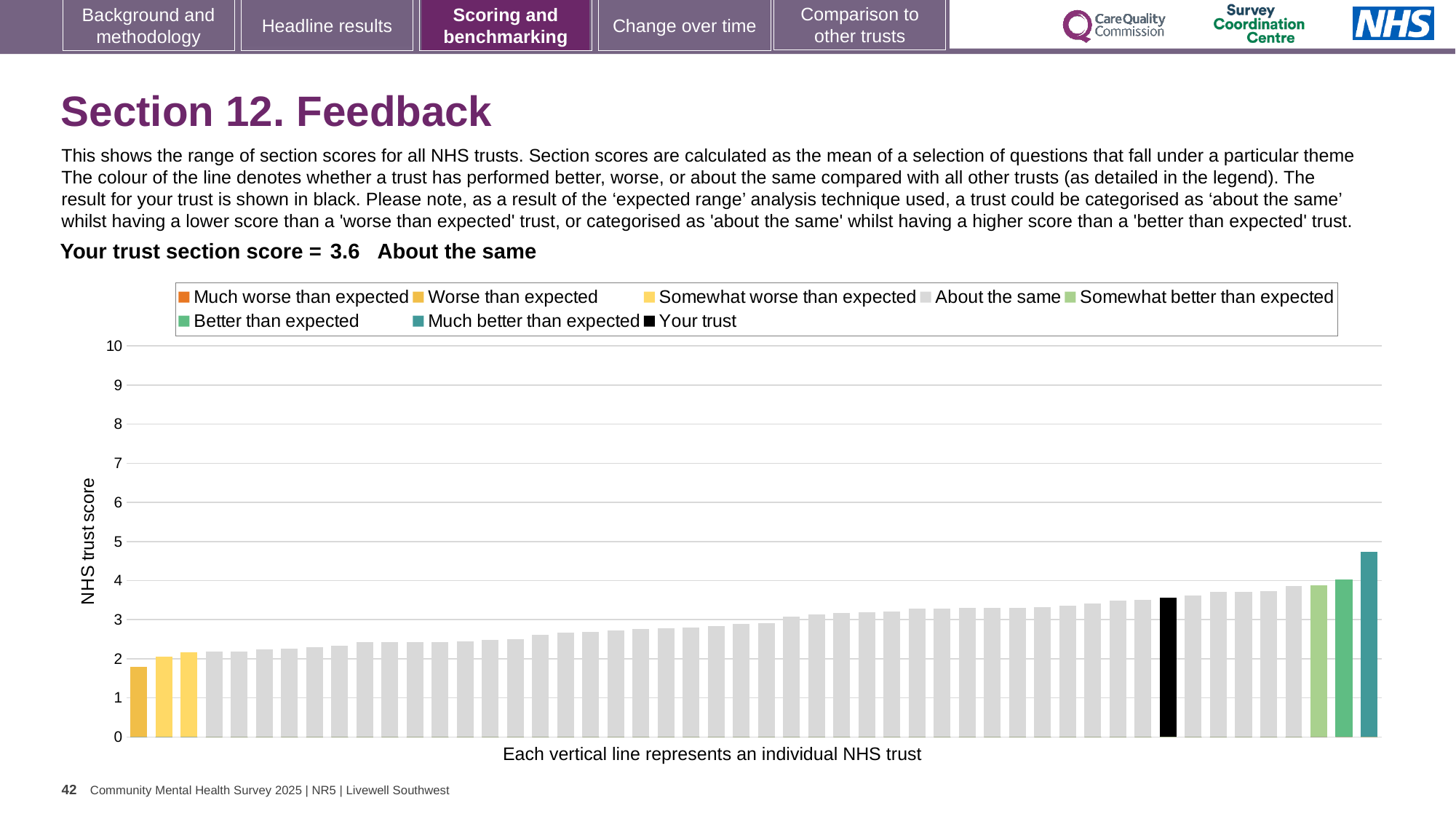
What kind of chart is shown on the slide? bar chart Is the value for the shortest bar on the chart greater or less than 2? less What is the trust's section score for Section 12. Feedback? 3.6 Which legend category does the tallest bar belong to? Much better than expected Do the bar values rise or fall moving from left to right along the x axis? rise Which category is the trust's section score placed in? About the same How many bars are coloured as 'Somewhat worse than expected'? 2 How many entries does the chart legend list? 8 What is the label on the y axis of the chart? NHS trust score Is the value for the black 'Your trust' bar greater or less than 4? less Is the value for the tallest bar (Much better than expected) greater or less than 4? greater Which legend category does the shortest bar belong to? Worse than expected